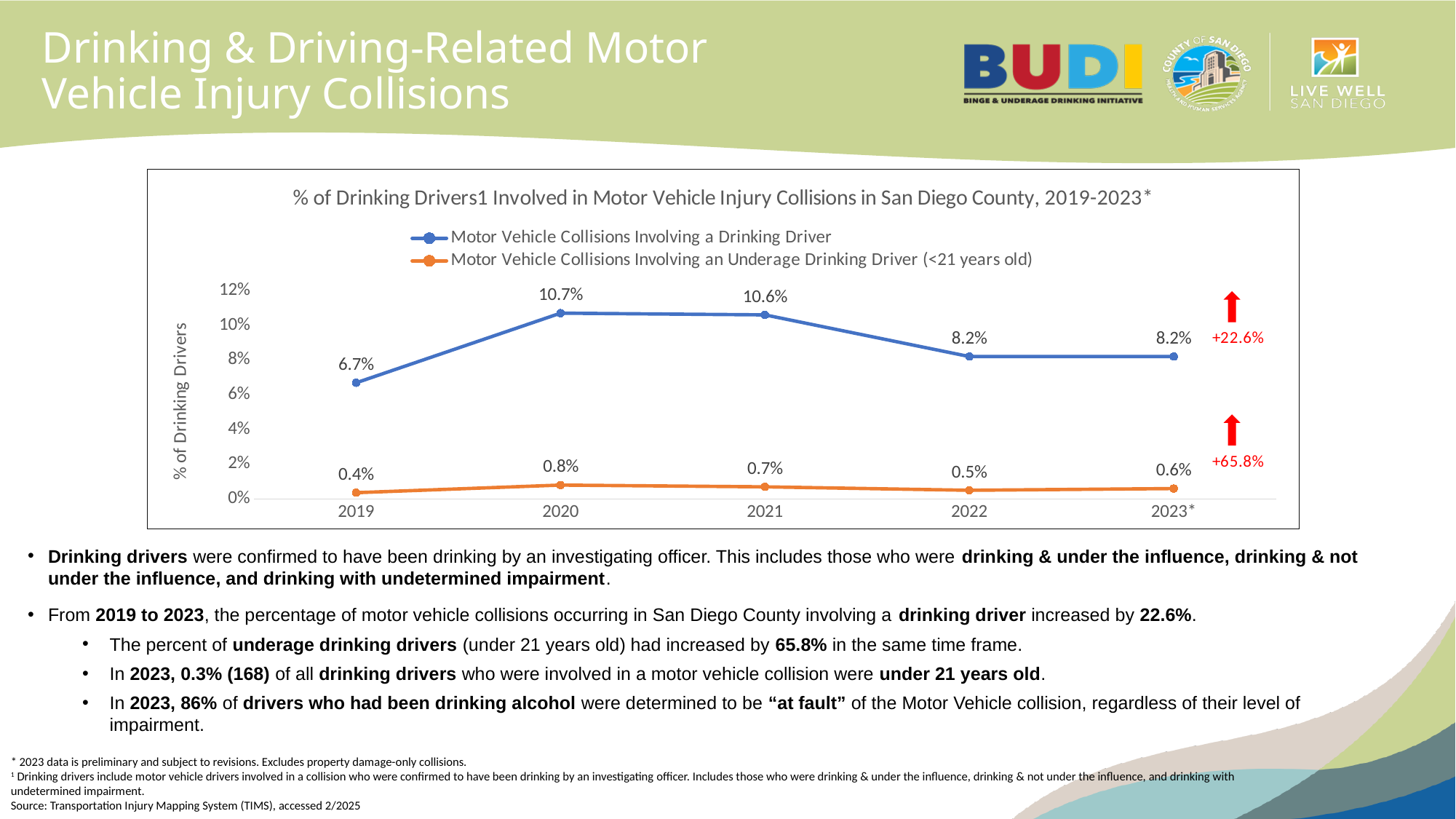
What was the percentage of motor vehicle collisions involving an underage drinking driver in 2019? 0.4% What was the percentage of motor vehicle collisions involving a drinking driver in 2020? 10.7% In which year was the percentage of collisions involving an underage drinking driver highest? 2020 What percentage change is shown next to the red arrow for the underage drinking driver series? +65.8% How many series does the legend list? 2 How many years are shown on the x axis? 5 What kind of chart is shown on the slide? Line chart In which year was the percentage of collisions involving a drinking driver lowest? 2019 Did the percentage of collisions involving a drinking driver rise or fall from 2021 to 2022? Fall Is the value for motor vehicle collisions involving a drinking driver in 2021 greater or less than 10%? greater Which was larger: the underage drinking driver percentage in 2021 or in 2022? 2021 What is the difference between the drinking driver percentage in 2020 and in 2019? 4.0%